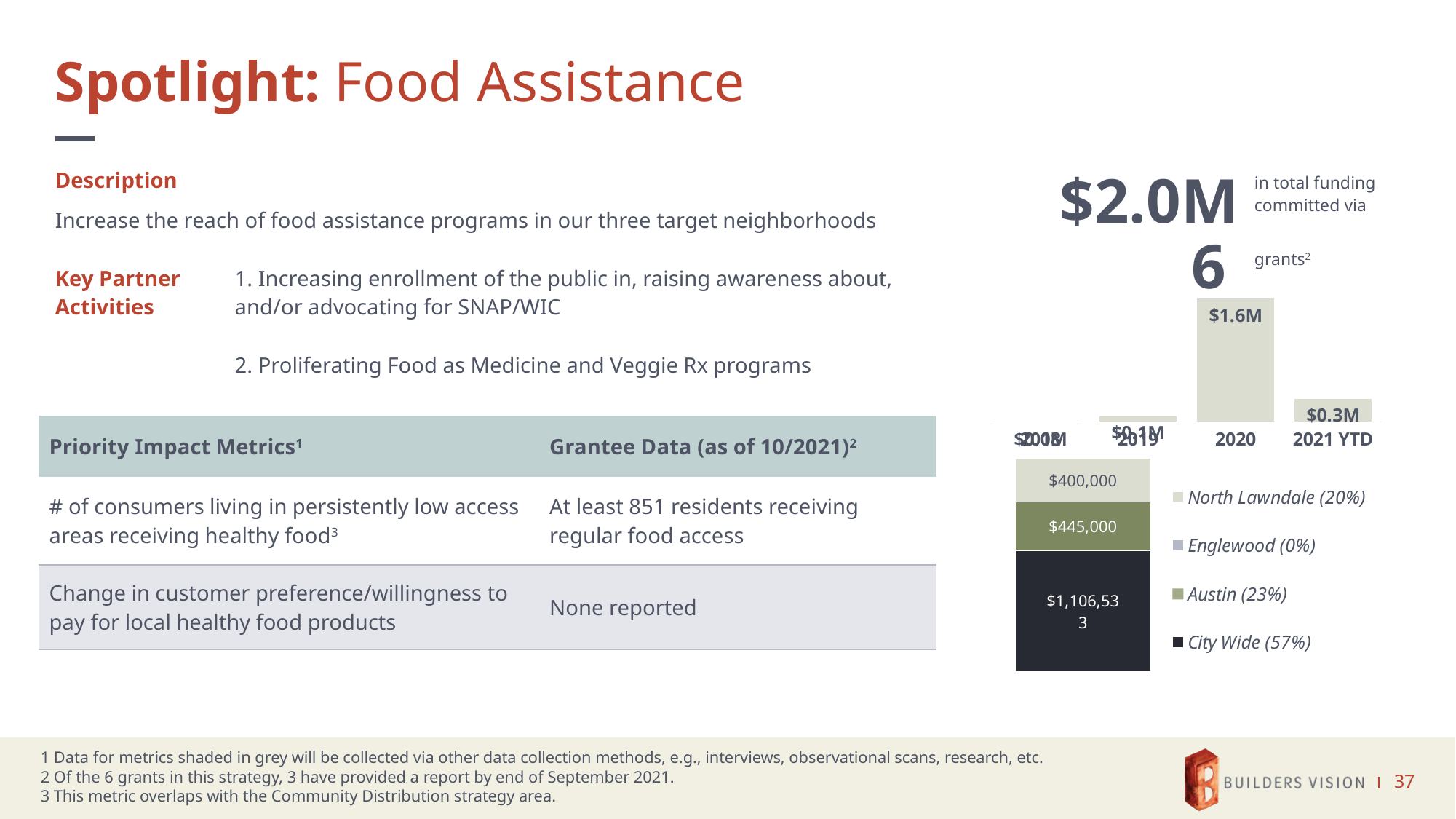
In the stacked bar chart by neighborhood, what is the value for the North Lawndale segment? $400,000 In the stacked bar chart by neighborhood, what percentage does the legend give for City Wide? 57% In the bar chart by year, which year has the highest funding? 2020 What kind of chart is the chart showing funding by year? bar chart In the stacked bar chart by neighborhood, how many entries does the legend list? 4 In the bar chart by year, what is the value for 2020? $1.6M In the bar chart by year, how many year categories are shown on the x axis? 4 In the stacked bar chart by neighborhood, what is the value for the City Wide segment? $1,106,533 In the stacked bar chart by neighborhood, what is the value for the Austin segment? $445,000 In the bar chart by year, what is the value for 2021 YTD? $0.3M In the bar chart by year, is the value for 2020 larger or smaller than the value for 2021 YTD? larger In the bar chart by year, what is the difference between the 2020 value and the 2021 YTD value? $1.3M